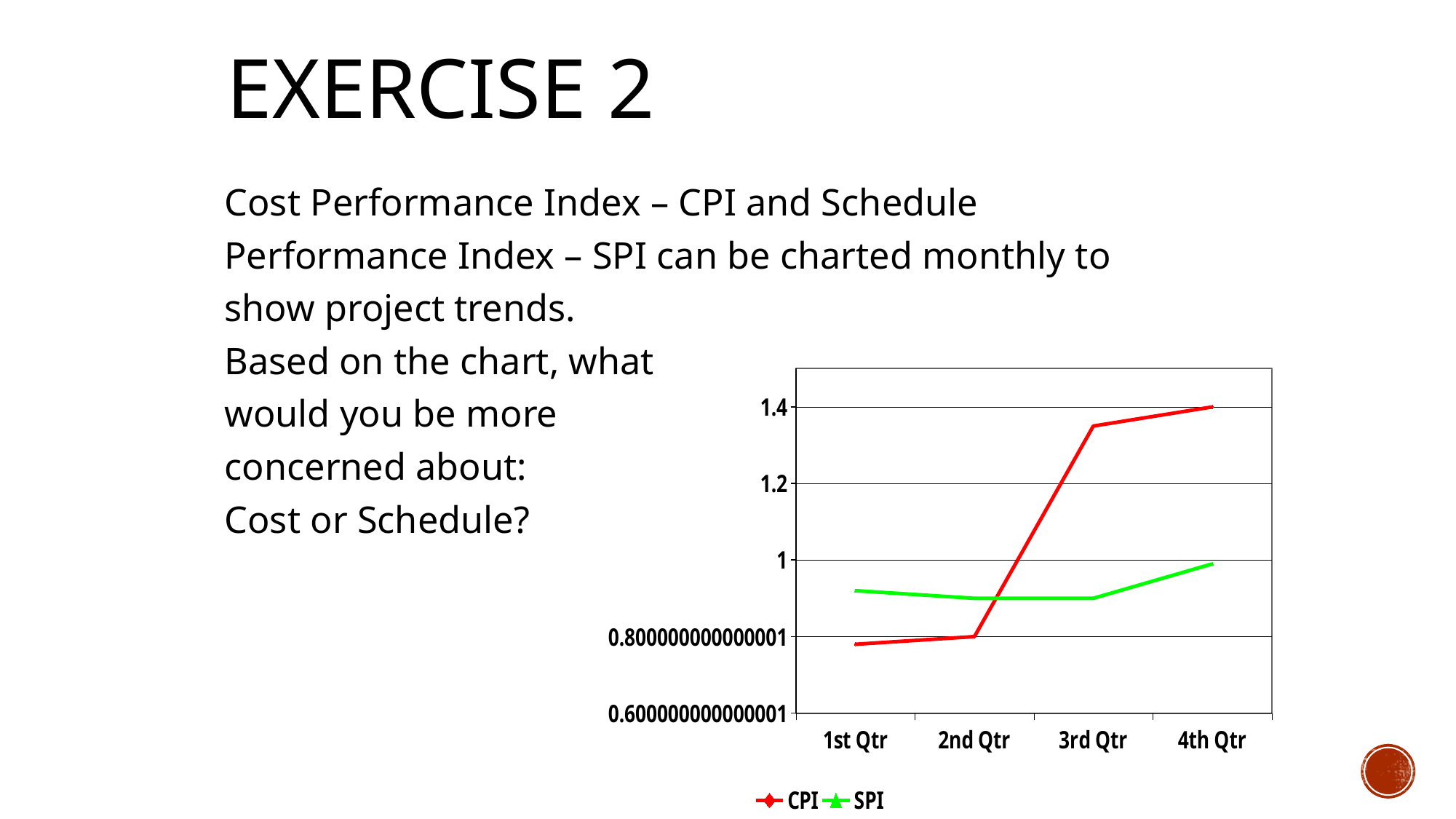
Is the SPI value for 1st Qtr greater or less than 1? less Which series has the larger value in 3rd Qtr, CPI or SPI? CPI What kind of chart is shown on the slide? line chart Is the SPI value for 2nd Qtr greater or less than 0.8? greater In which quarter does CPI reach its highest value? 4th Qtr Which series is drawn in green on the chart? SPI Which series has the larger value in 1st Qtr, CPI or SPI? SPI Is the CPI value for 3rd Qtr greater or less than 1.2? greater How many quarters are plotted along the x axis of the chart? 4 Which series is drawn in red on the chart? CPI How many series does the chart legend list? 2 Does the CPI line rise or fall from 1st Qtr to 4th Qtr? rise